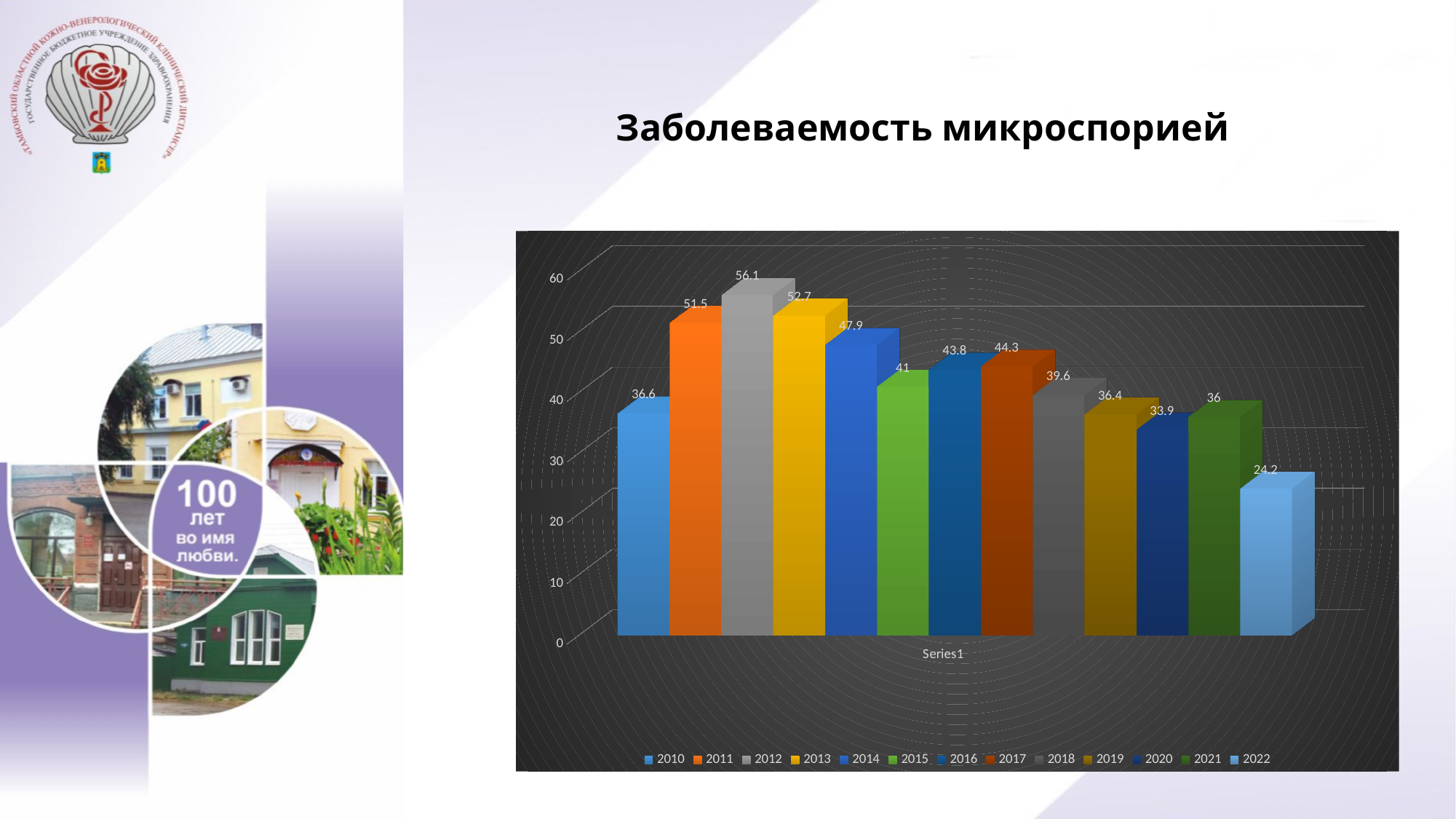
Which year has the lowest value? 2022 What is the value for 2016? 43.8 Which year has the highest value? 2012 How many entries does the legend list? 13 How many bars are plotted on the chart? 13 What is the title of the chart? Заболеваемость микроспорией What is the difference between the values for 2012 and 2022? 31.9 Which is larger, the value for 2011 or the value for 2013? 2013 What kind of chart is shown on the slide? bar chart What is the value for 2022? 24.2 What is the value for 2012? 56.1 Is the value for 2014 greater or less than 40? greater